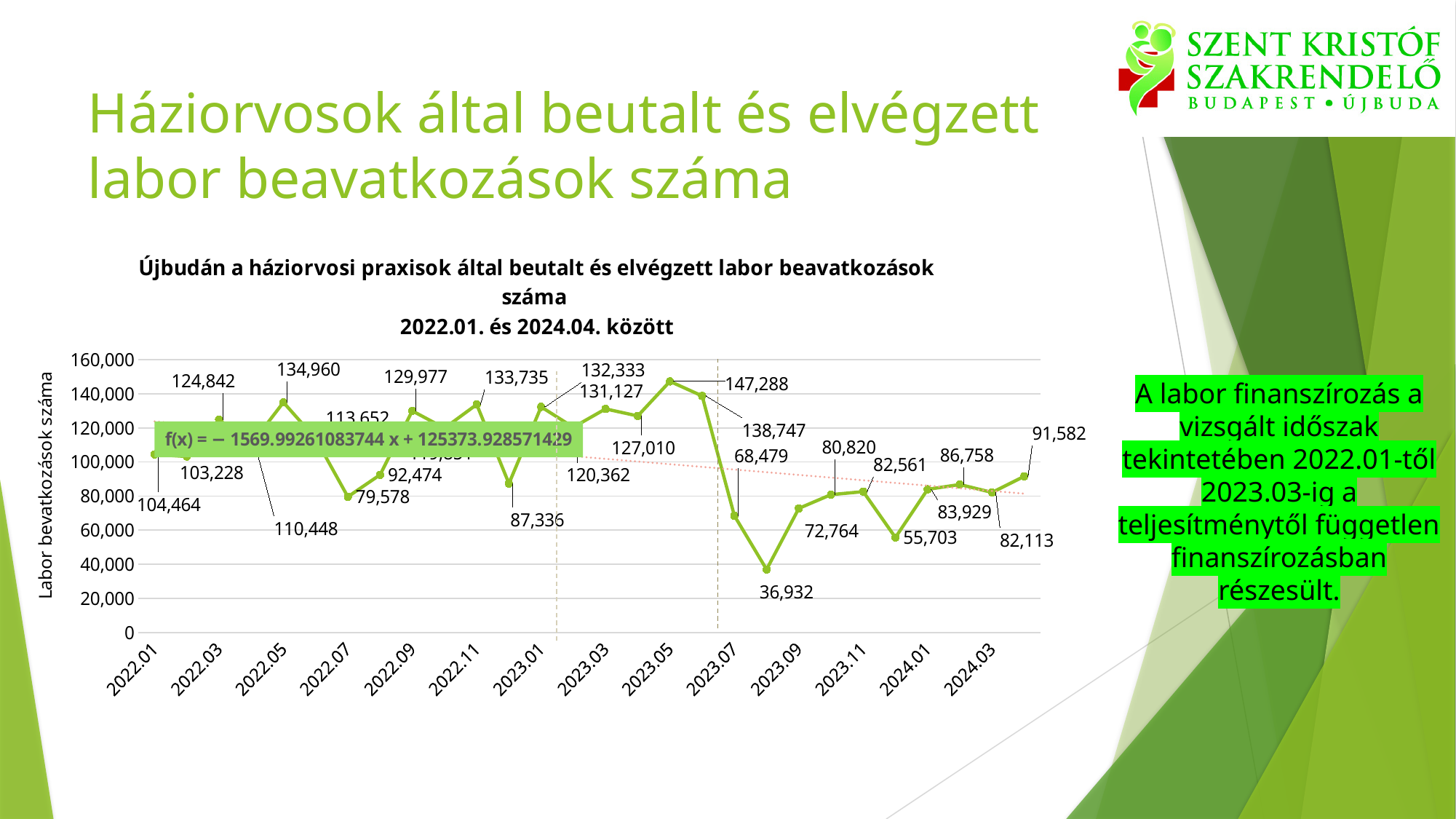
What kind of chart is shown on the slide? line chart What is the title of the vertical axis? Labor beavatkozások száma Is the value for 2023.08 greater or less than 40,000? less Which is larger, the value for 2022.01 or the value for 2024.03? 2022.01 According to the dotted trend line, do the values generally rise or fall over the period? fall What is the value for 2023.09? 72,764 What is the value for 2023.05? 147,288 What is the difference between the highest value (147,288) and the lowest value (36,932)? 110,356 What is the value for 2022.01? 104,464 What is the value for 2024.03? 82,113 Which month has the lowest value? 2023.08 Which month has the highest value? 2023.05